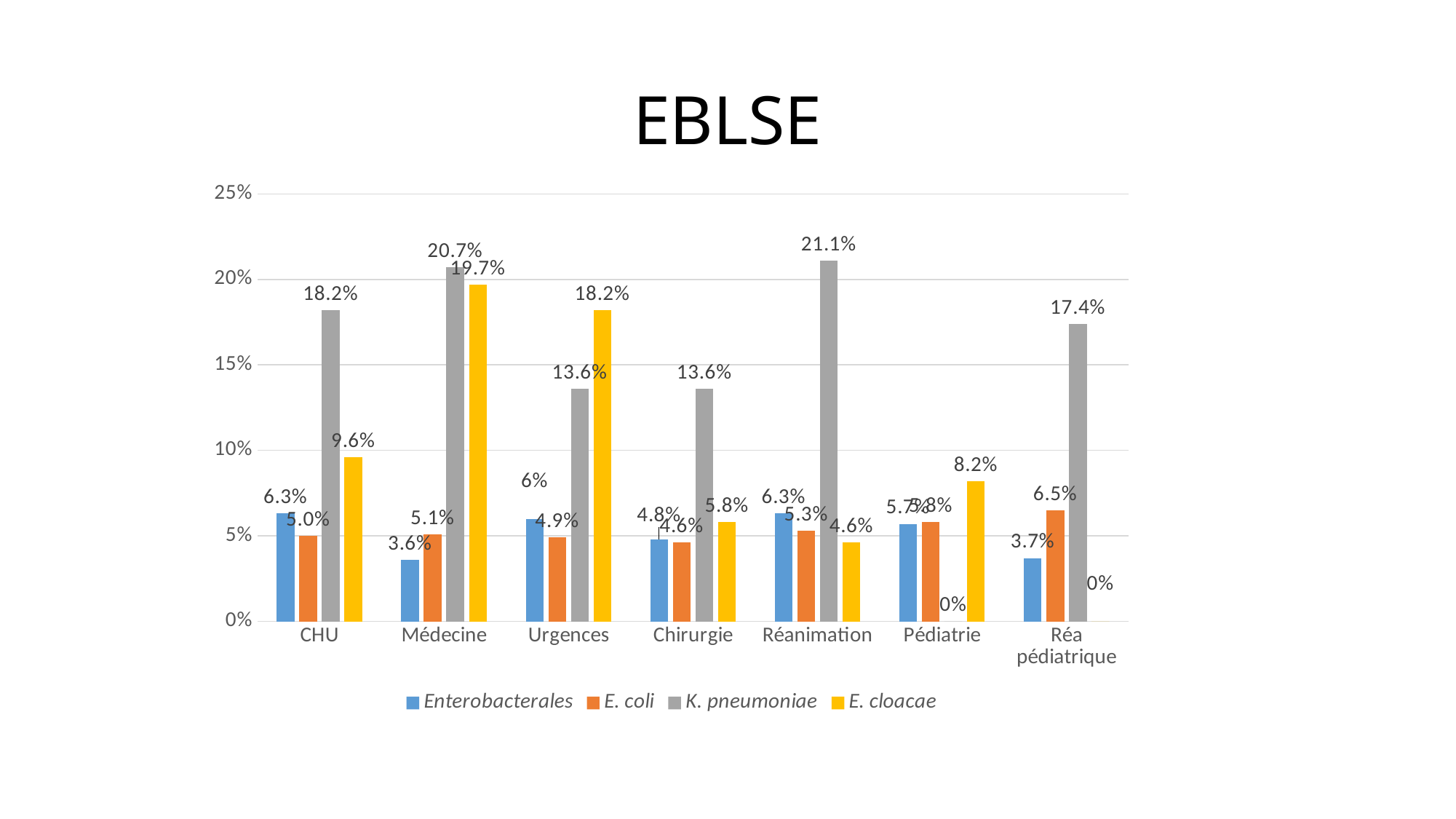
Which category has the lowest value for E. cloacae? Réa pédiatrique What is the difference between the K. pneumoniae value and the E. cloacae value in CHU? 8.6% What is the value for E. coli in Chirurgie? 4.6% What is the value for Enterobacterales in Réa pédiatrique? 3.7% What is the value for E. cloacae in Médecine? 19.7% Is the value for K. pneumoniae in Réa pédiatrique greater or less than 15%? greater What is the value for K. pneumoniae in Réanimation? 21.1% Which category has the highest value for K. pneumoniae? Réanimation What kind of chart is shown on the slide? Bar chart How many series does the legend list? 4 How many categories are shown on the x axis? 7 Which is larger in Urgences: the K. pneumoniae value or the E. cloacae value? E. cloacae